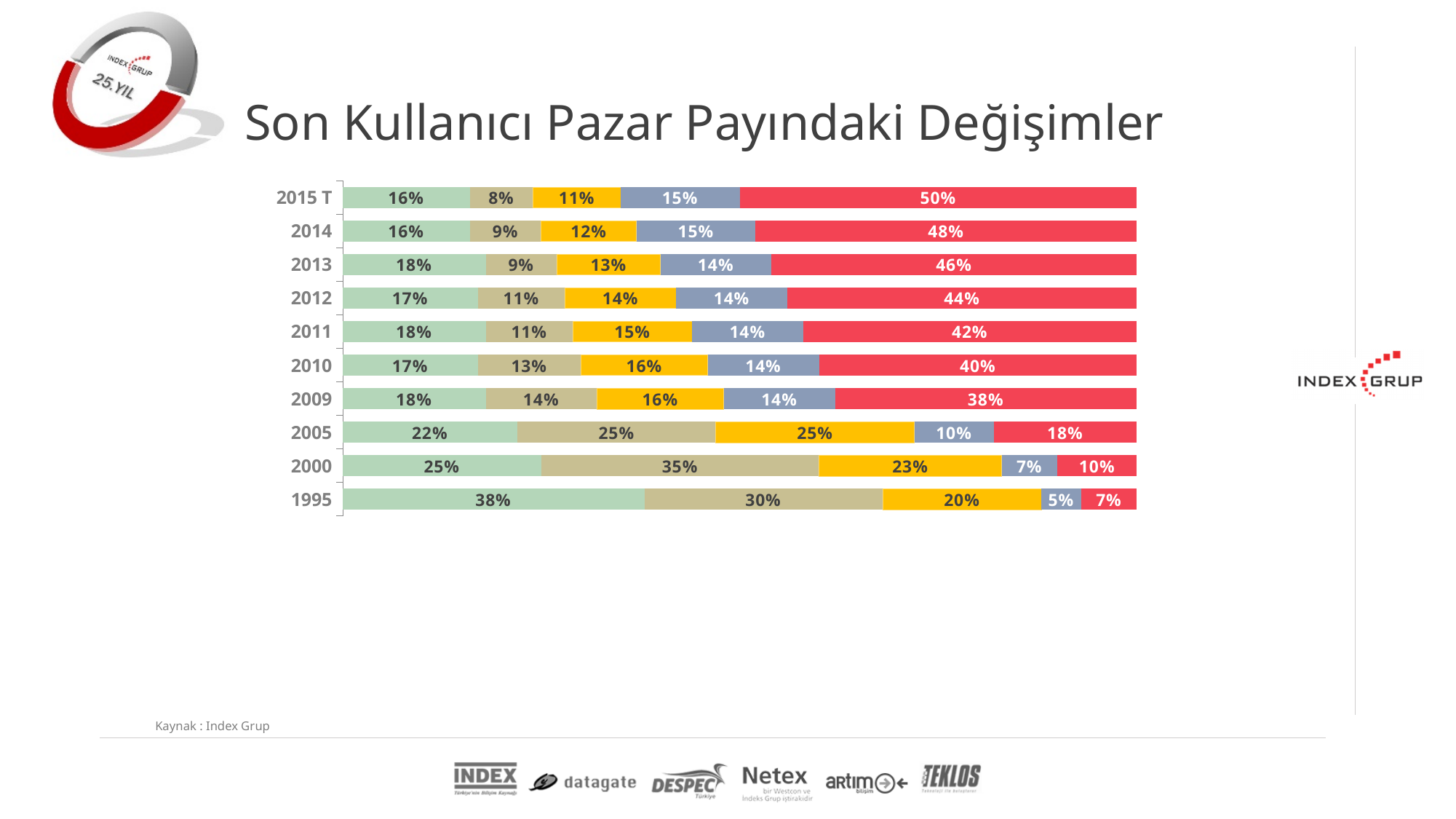
What is the value of the grey-blue segment for 2000? 7% What kind of chart is shown on the slide? Stacked bar chart What is the value of the red segment for 2015 T? 50% What is the difference between the red segment values for 2015 T and 1995? 43% What is the title of the slide containing the chart? Son Kullanıcı Pazar Payındaki Değişimler What is the value of the yellow segment for 2005? 25% How does the red segment value change from 1995 to 2015 T? It rises Is the red segment value for 2014 larger than the red segment value for 2009? Yes, 48% vs 38% Which year has the highest value for the red segment? 2015 T How many year categories are shown on the chart? 10 Which year has the lowest value for the green (first) segment? 2015 T and 2014 (16%) What is the value of the green (first) segment for 1995? 38%